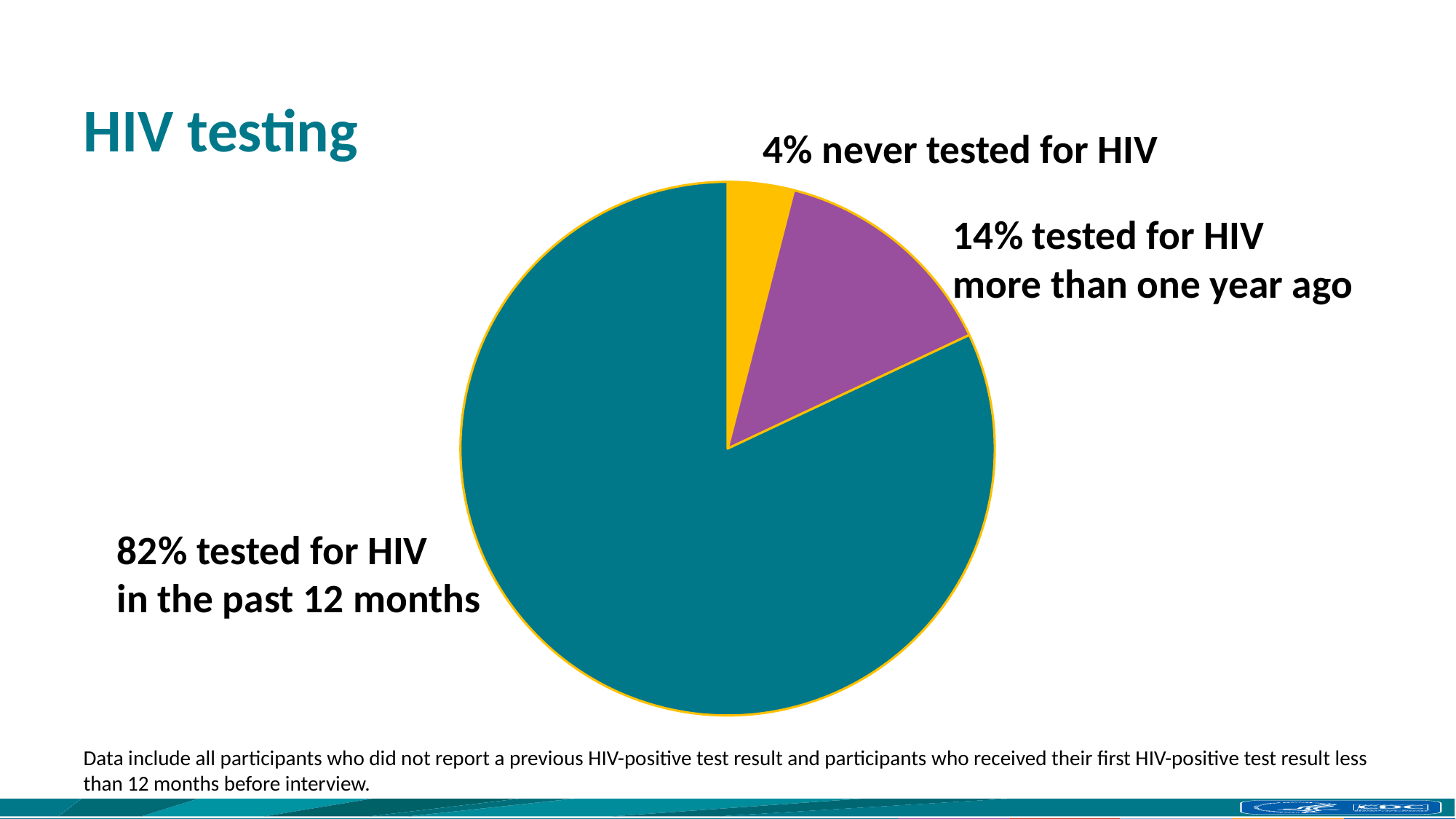
What percentage of participants were tested for HIV in the past 12 months? 82% Which is larger: the share tested more than one year ago or the share never tested? tested more than one year ago What is the difference in percentage points between those tested in the past 12 months and those tested more than one year ago? 68 What kind of chart is shown on the slide? pie chart Which category has the smallest share of the pie? never tested for HIV What is the title of the slide? HIV testing What is the difference in percentage points between those tested more than one year ago and those never tested? 10 How many slices does the pie chart have? 3 Which category has the largest share of the pie? tested for HIV in the past 12 months What colour is the slice for participants tested for HIV in the past 12 months? teal What percentage of participants were tested for HIV more than one year ago? 14% What percentage of participants were never tested for HIV? 4%